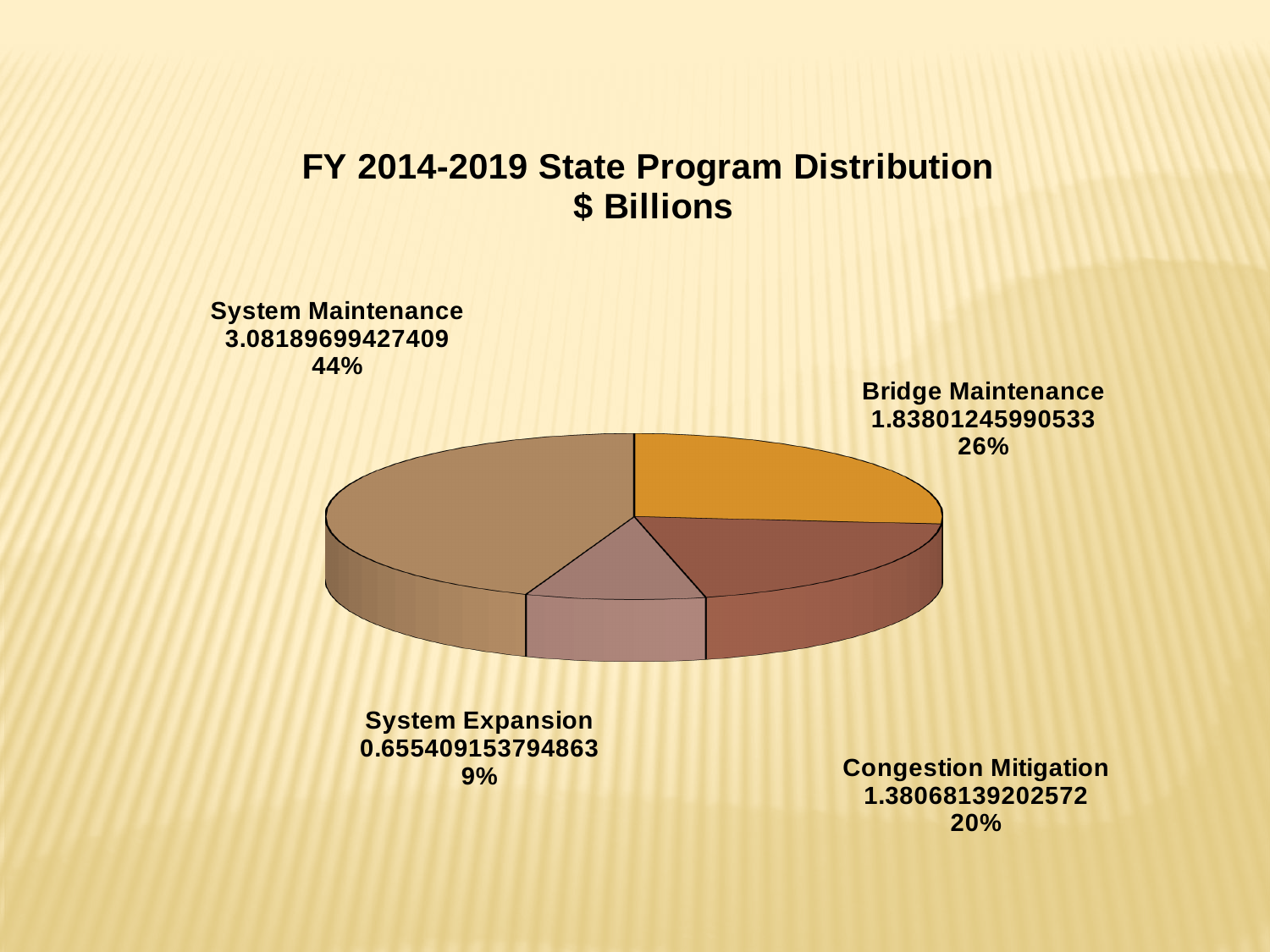
What percentage share does System Maintenance have? 44% What kind of chart is shown on the slide? Pie chart What percentage share does System Expansion have? 9% Which category has the smallest share of the pie? System Expansion What percentage share does Congestion Mitigation have? 20% What is the title of the chart? FY 2014-2019 State Program Distribution $ Billions What is the value shown for System Expansion? 0.655409153794863 What is the value shown for System Maintenance? 3.08189699427409 How many slices does the pie chart have? 4 Which category has the largest share of the pie? System Maintenance Which has a larger share, Bridge Maintenance or Congestion Mitigation? Bridge Maintenance